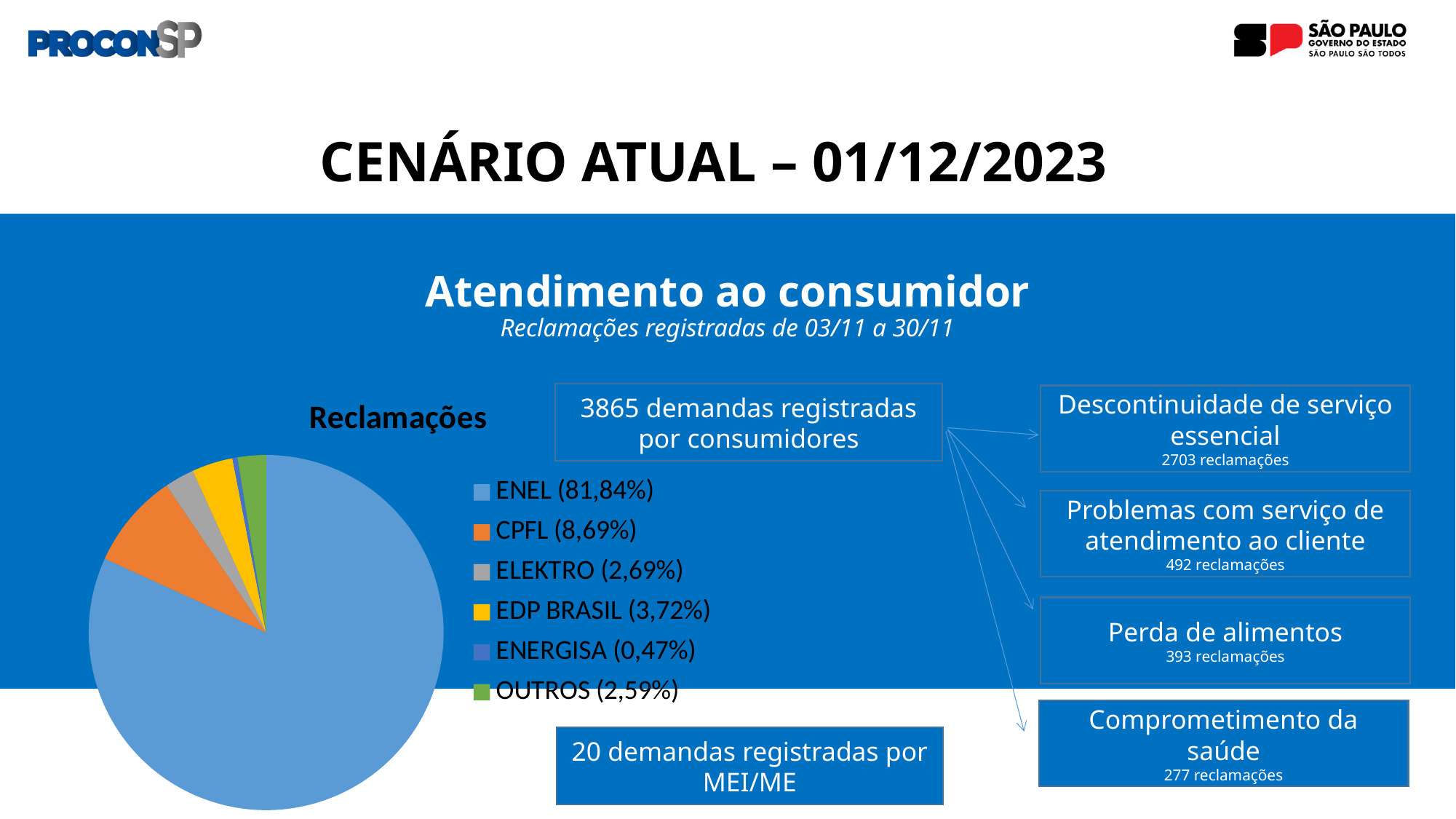
What is the difference in percentage points between ENEL's share and CPFL's share? 73,15% What is the title of the pie chart? Reclamações What percentage is shown for CPFL in the pie chart? 8,69% What type of chart is shown on the slide? Pie chart Which category has the largest slice of the pie chart? ENEL What percentage is shown for ENERGISA in the pie chart? 0,47% How many categories are shown in the pie chart? 6 Which colour represents OUTROS in the pie chart? Green What share of the pie chart does ENEL account for? 81,84% Which category has the smallest slice of the pie chart? ENERGISA Which has a larger share in the pie chart, EDP BRASIL or ELEKTRO? EDP BRASIL What percentage is shown for EDP BRASIL in the pie chart? 3,72%